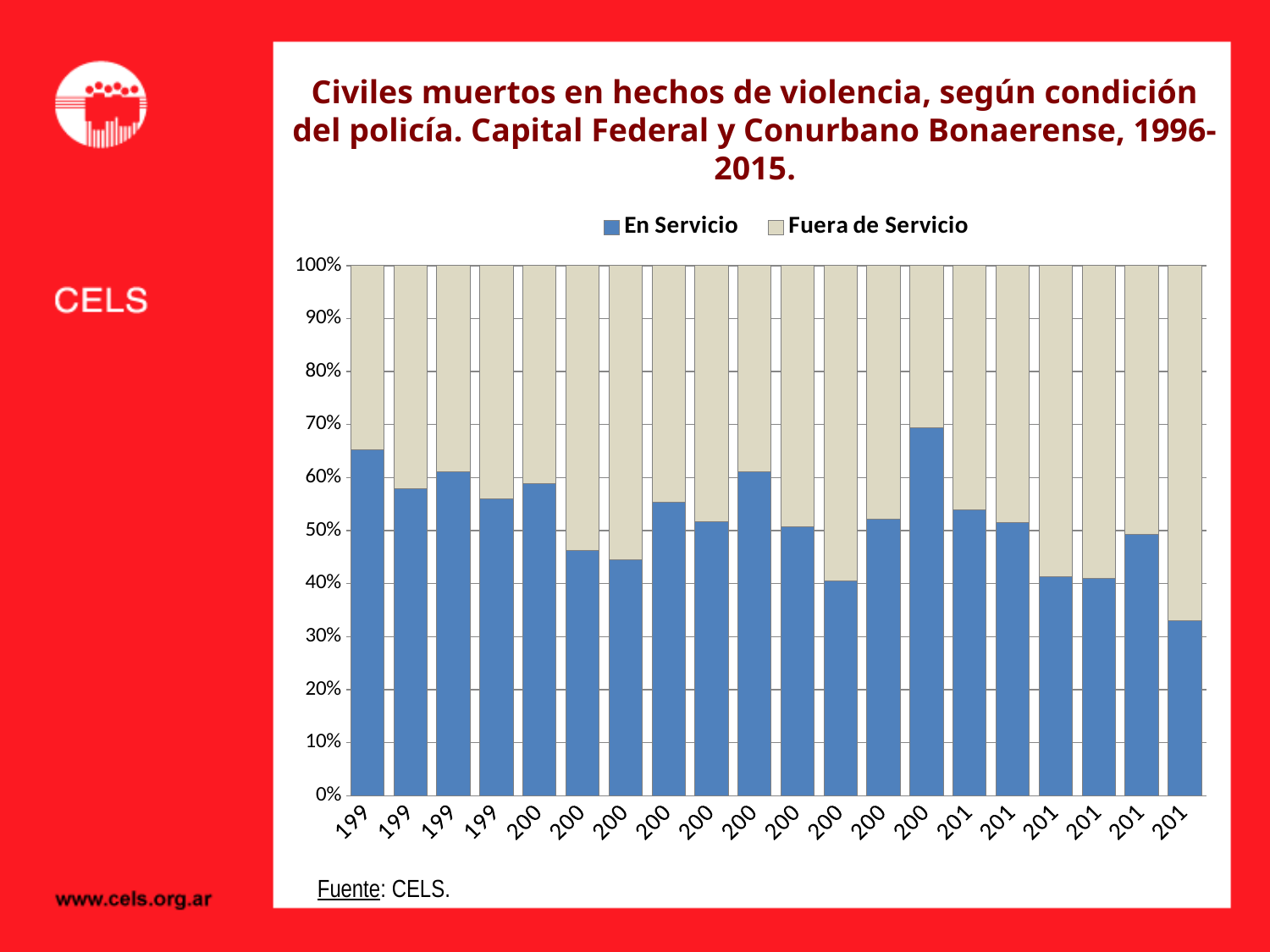
How many bars (years) are plotted in the chart? 20 Which bar has the lowest En Servicio share? The last (rightmost) bar What value does the top of every stacked bar reach on the y axis? 100% What kind of chart is shown on the slide? Stacked bar chart Is the En Servicio share in the first (leftmost) bar greater or less than 60%? greater Is the En Servicio share in the last (rightmost) bar greater or less than 40%? less Which bar has the highest En Servicio share? The 14th bar from the left Is the En Servicio share in the last (rightmost) bar greater or less than 30%? greater How many series does the legend list? 2 What are the two series named in the legend? En Servicio and Fuera de Servicio Is the En Servicio share in the first bar larger or smaller than in the last bar? larger Which series is shown in blue? En Servicio